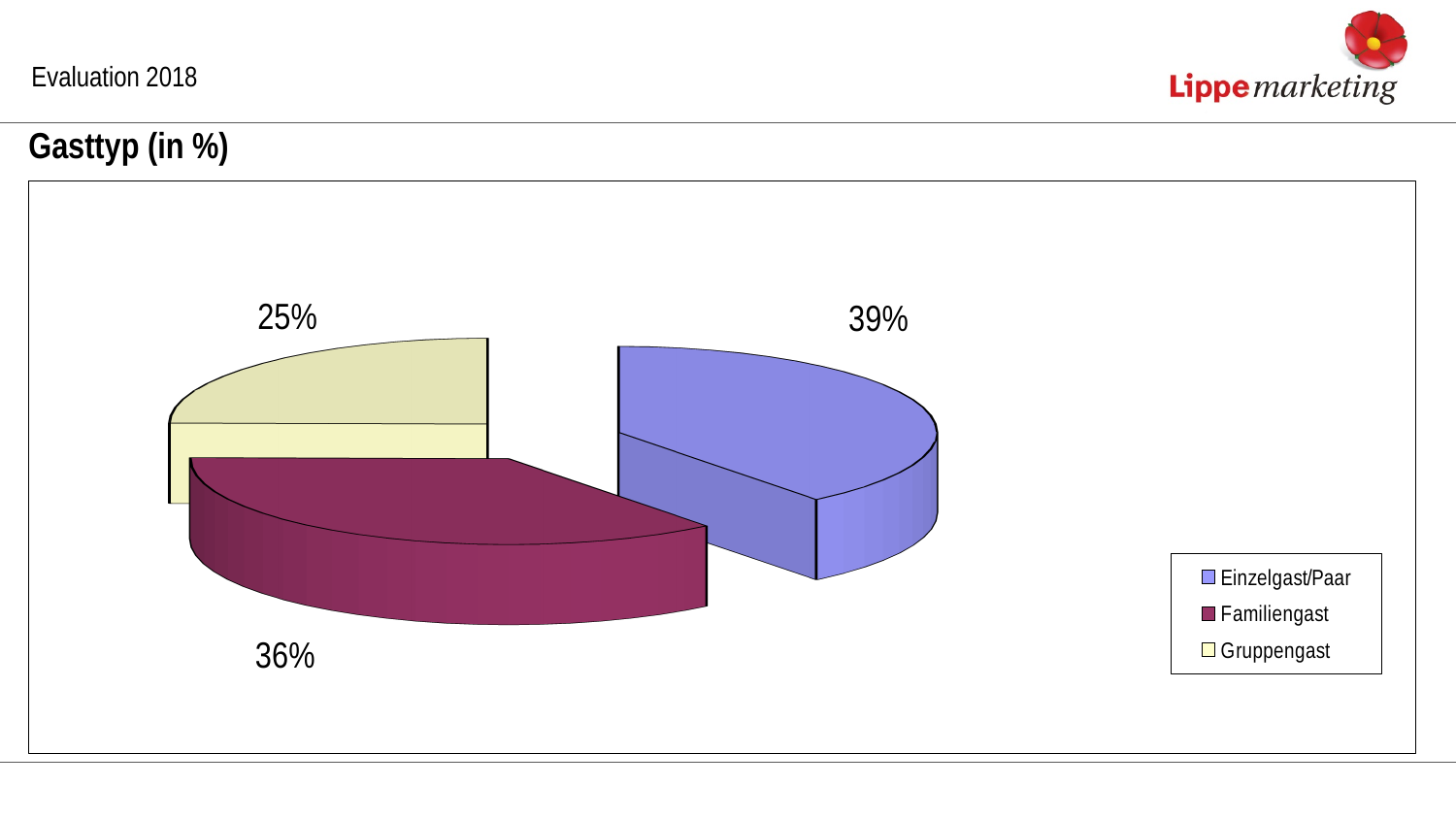
What share of the pie does Familiengast have? 36% What is the difference in percentage points between Familiengast and Gruppengast? 11 How many slices does the pie chart have? 3 Which is larger, the share for Familiengast or the share for Gruppengast? Familiengast What is the difference in percentage points between Einzelgast/Paar and Gruppengast? 14 Which guest type has the smallest share? Gruppengast What share of the pie does Einzelgast/Paar have? 39% What is the title of the chart? Gasttyp (in %) What share of the pie does Gruppengast have? 25% Which colour represents Familiengast in the legend? Dark red What kind of chart is shown on the slide? Pie chart Which guest type has the largest share? Einzelgast/Paar